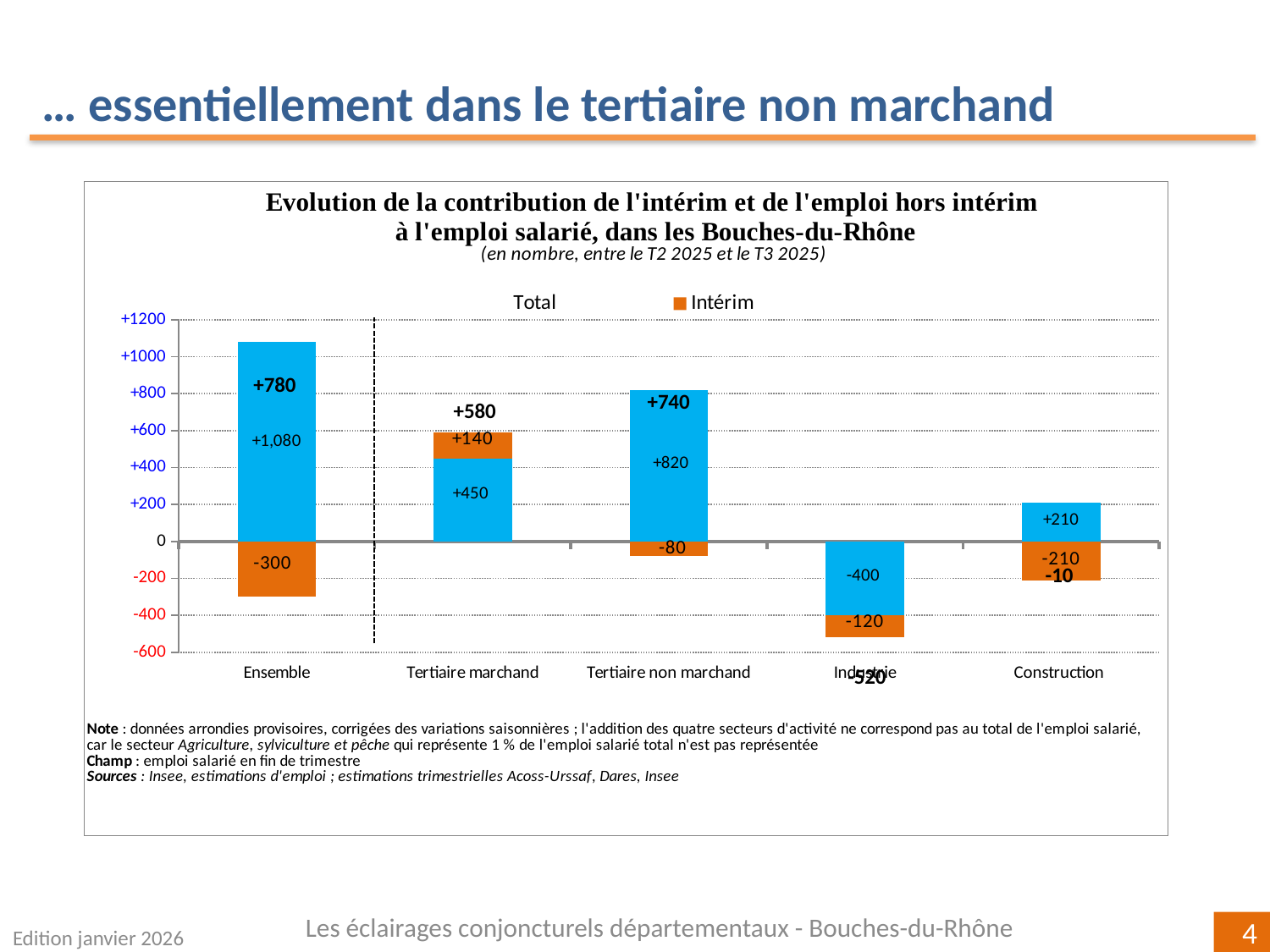
What is the Intérim value for Tertiaire marchand? +140 What is the value of the blue bar for Industrie? -400 What is the total value labelled for Tertiaire non marchand? +740 What is the Intérim value for Ensemble? -300 Which category has the lowest total value? Industrie Which category has the highest total value? Ensemble What is the total value labelled for Construction? -10 How many categories are shown on the x axis of the chart? 5 What kind of chart is shown on the slide? bar chart How many series does the chart legend list? 2 Which is larger, the Intérim value for Tertiaire marchand or the Intérim value for Construction? Tertiaire marchand What is the difference between the total for Tertiaire non marchand and the total for Tertiaire marchand? 160